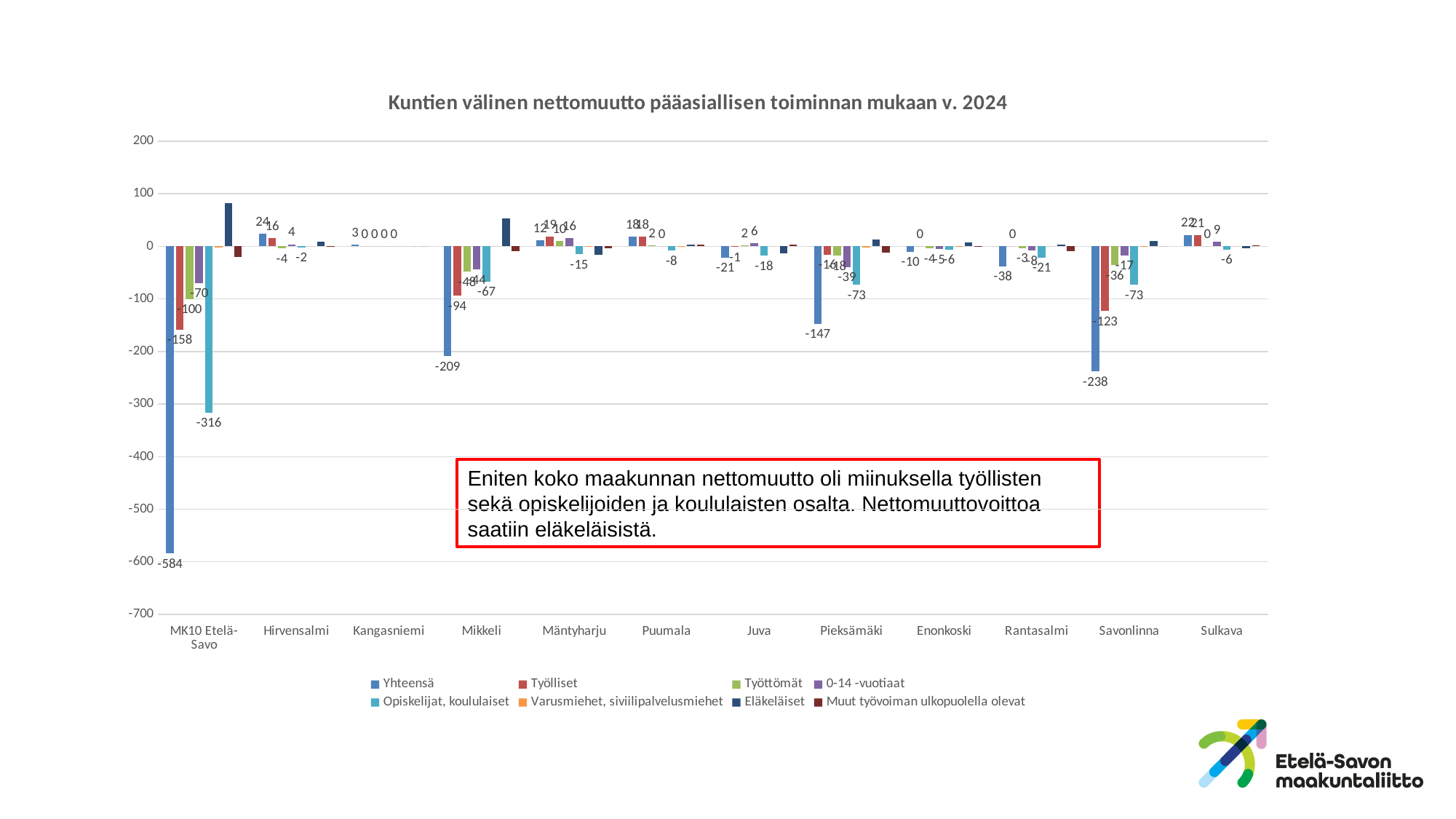
What is the Yhteensä value for Pieksämäki? -147 Which is larger, the Työlliset value for Mikkeli or for Savonlinna? Mikkeli What is the Yhteensä value for Savonlinna? -238 What kind of chart is shown on the slide? bar chart What is the title of the chart? Kuntien välinen nettomuutto pääasiallisen toiminnan mukaan v. 2024 How many categories are shown on the x axis? 12 Is the Eläkeläiset value for MK10 Etelä-Savo greater or less than 50? greater What is the Yhteensä value for MK10 Etelä-Savo? -584 Which category has the lowest Yhteensä value? MK10 Etelä-Savo What is the difference between the Yhteensä values for Mikkeli (-209) and Savonlinna (-238)? 29 How many series does the legend list? 8 What is the Opiskelijat, koululaiset value for MK10 Etelä-Savo? -316